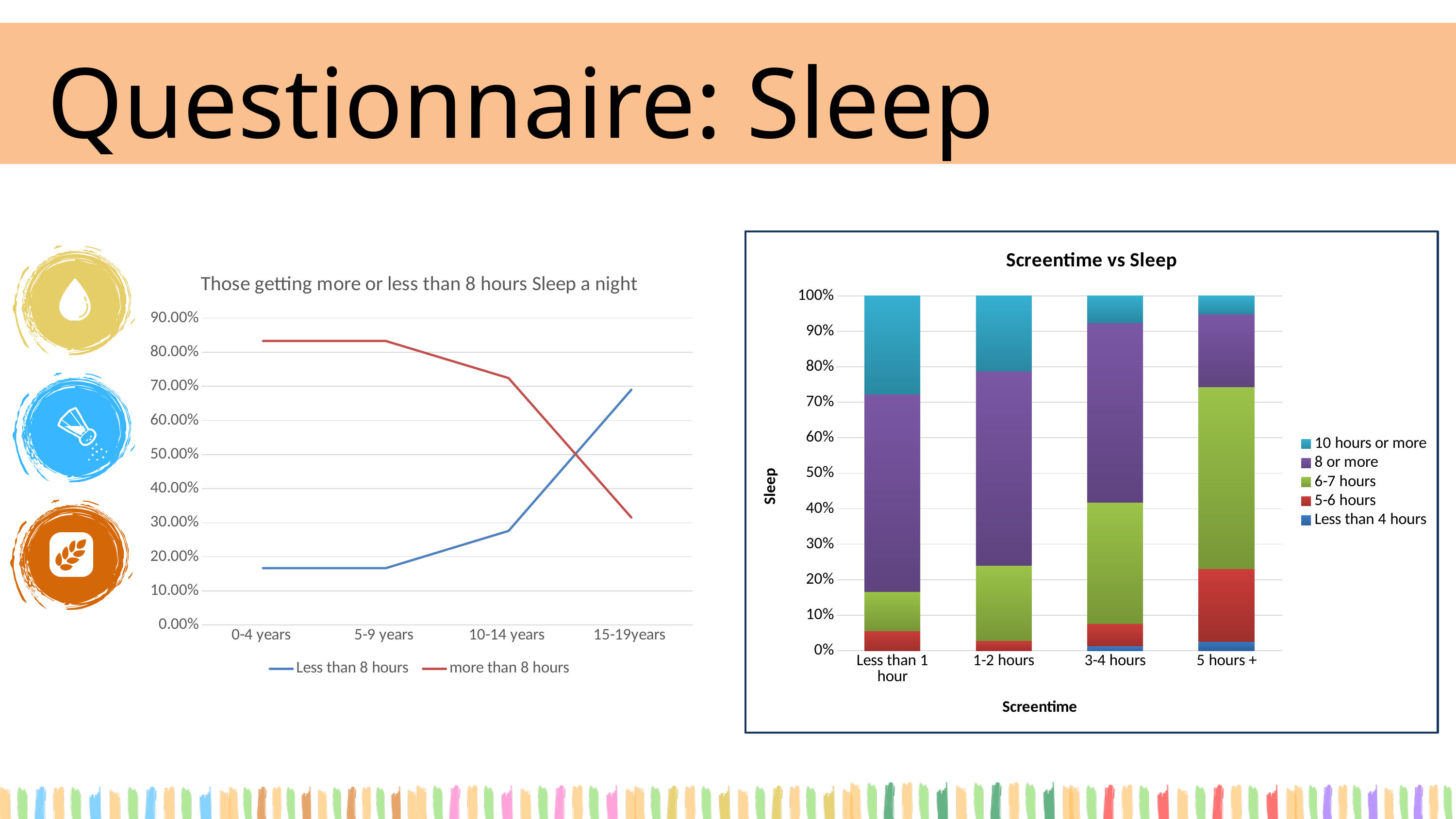
What kind of chart is the chart titled "Those getting more or less than 8 hours Sleep a night"? line chart In the "Screentime vs Sleep" chart, how many screentime categories are shown on the x axis? 4 In the "Screentime vs Sleep" chart, how many series does the legend list? 5 In the chart titled "Those getting more or less than 8 hours Sleep a night", is the value for "Less than 8 hours" at 0-4 years greater or less than 20.00%? less In the chart titled "Those getting more or less than 8 hours Sleep a night", at 10-14 years, which series has the larger value: "Less than 8 hours" or "more than 8 hours"? more than 8 hours In the chart titled "Those getting more or less than 8 hours Sleep a night", is the value for "more than 8 hours" at 15-19years greater or less than 40.00%? less In the chart titled "Those getting more or less than 8 hours Sleep a night", how many series does the legend list? 2 In the chart titled "Those getting more or less than 8 hours Sleep a night", does the "Less than 8 hours" line rise or fall from 0-4 years to 15-19years? rise In the chart titled "Those getting more or less than 8 hours Sleep a night", how many age groups are shown on the x axis? 4 In the chart titled "Those getting more or less than 8 hours Sleep a night", which age group has the highest value for "Less than 8 hours"? 15-19years What kind of chart is the "Screentime vs Sleep" chart? bar chart In the chart titled "Those getting more or less than 8 hours Sleep a night", does the "more than 8 hours" line rise or fall from 0-4 years to 15-19years? fall